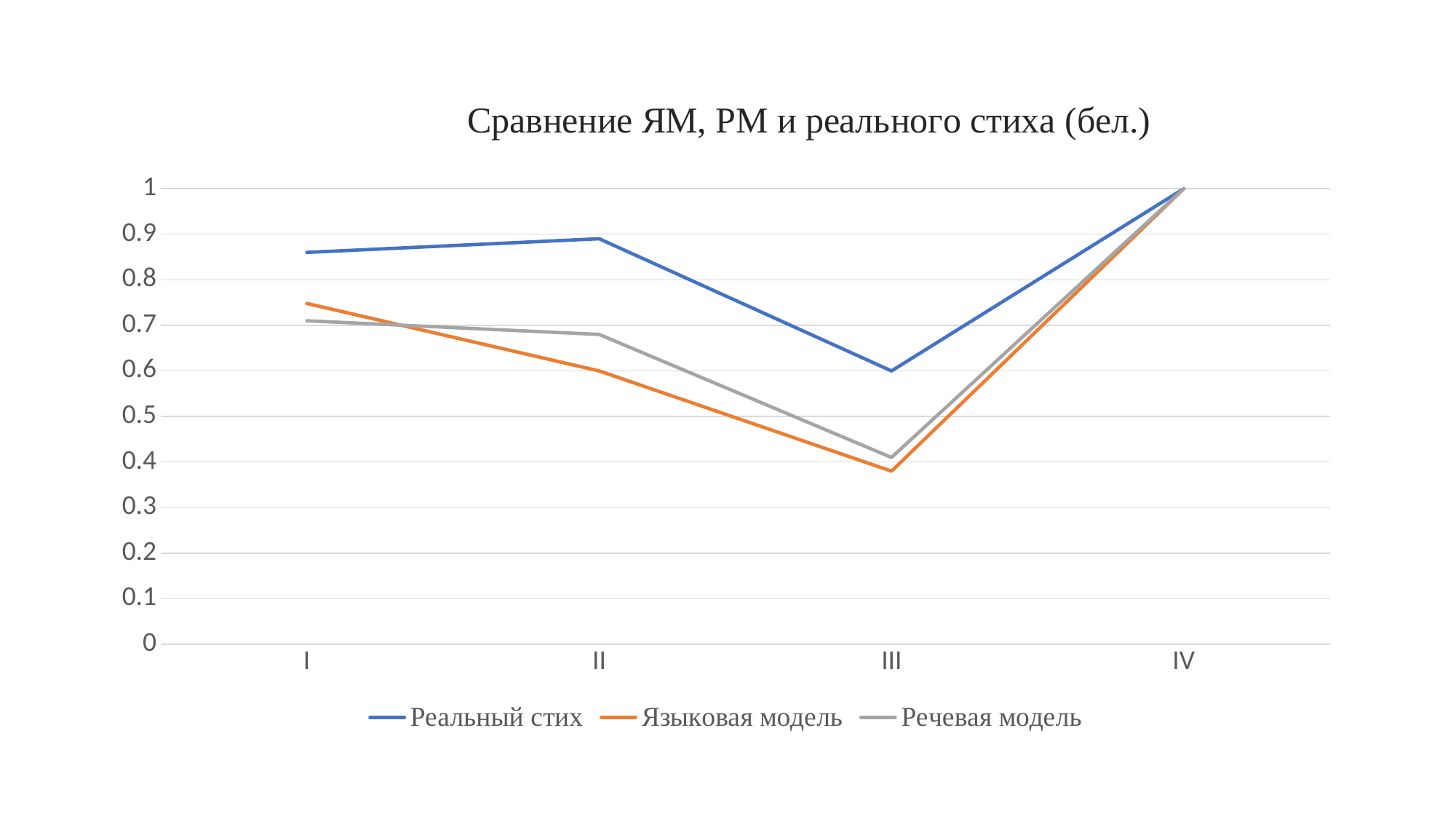
At which category does Языковая модель reach its lowest value? III What is the value of Реальный стих at category IV? 1 At category I, which is larger: Реальный стих or Речевая модель? Реальный стих What is the value of Языковая модель at category IV? 1 How many series does the legend list? 3 Does the value of Реальный стих rise or fall from category II to category III? fall Is the value for Реальный стих at category I greater or less than 0.8? greater What is the title of the chart? Сравнение ЯМ, РМ и реального стиха (бел.) Is the value for Языковая модель at category III greater or less than 0.5? less How many categories are plotted along the x axis? 4 At which category does Реальный стих reach its highest value? IV What kind of chart is shown on the slide? line chart